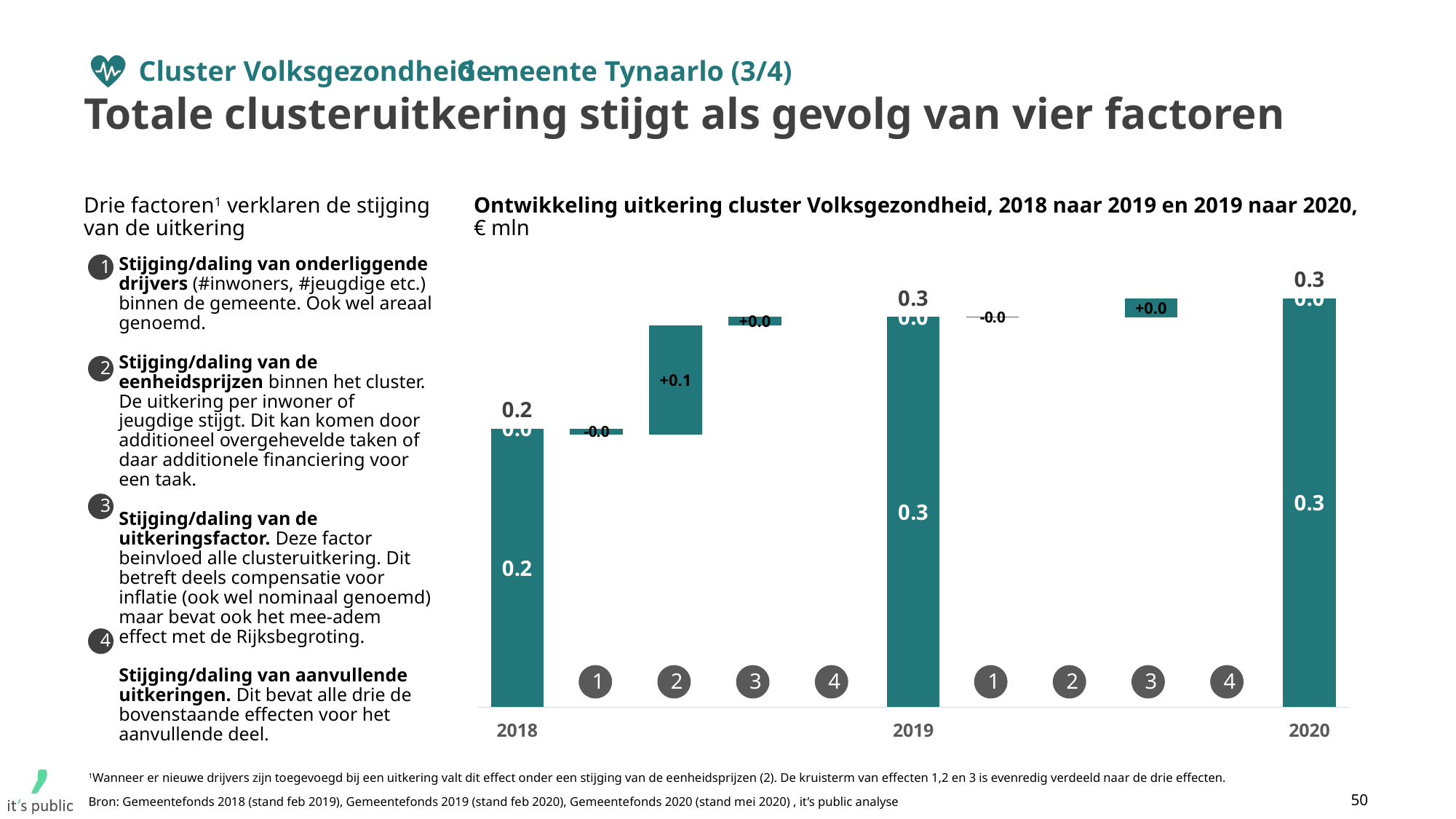
Does the total uitkering rise or fall from 2018 to 2020? rise In what unit are the values on the chart expressed? € mln How many year totals are shown on the chart? 3 What is the total uitkering for 2020 shown on the chart? 0.3 Which year has the higher total uitkering, 2018 or 2019? 2019 What is the difference between the 2019 total and the 2018 total? 0.1 What is the total uitkering for 2018 shown on the chart? 0.2 What kind of chart is shown on the slide? bar chart What is the contribution of factor 2 in the step from 2018 to 2019? +0.1 What is the total uitkering for 2019 shown on the chart? 0.3 Which factor has the largest contribution in the step from 2018 to 2019? 2 What is the contribution of factor 1 in the step from 2018 to 2019? -0.0